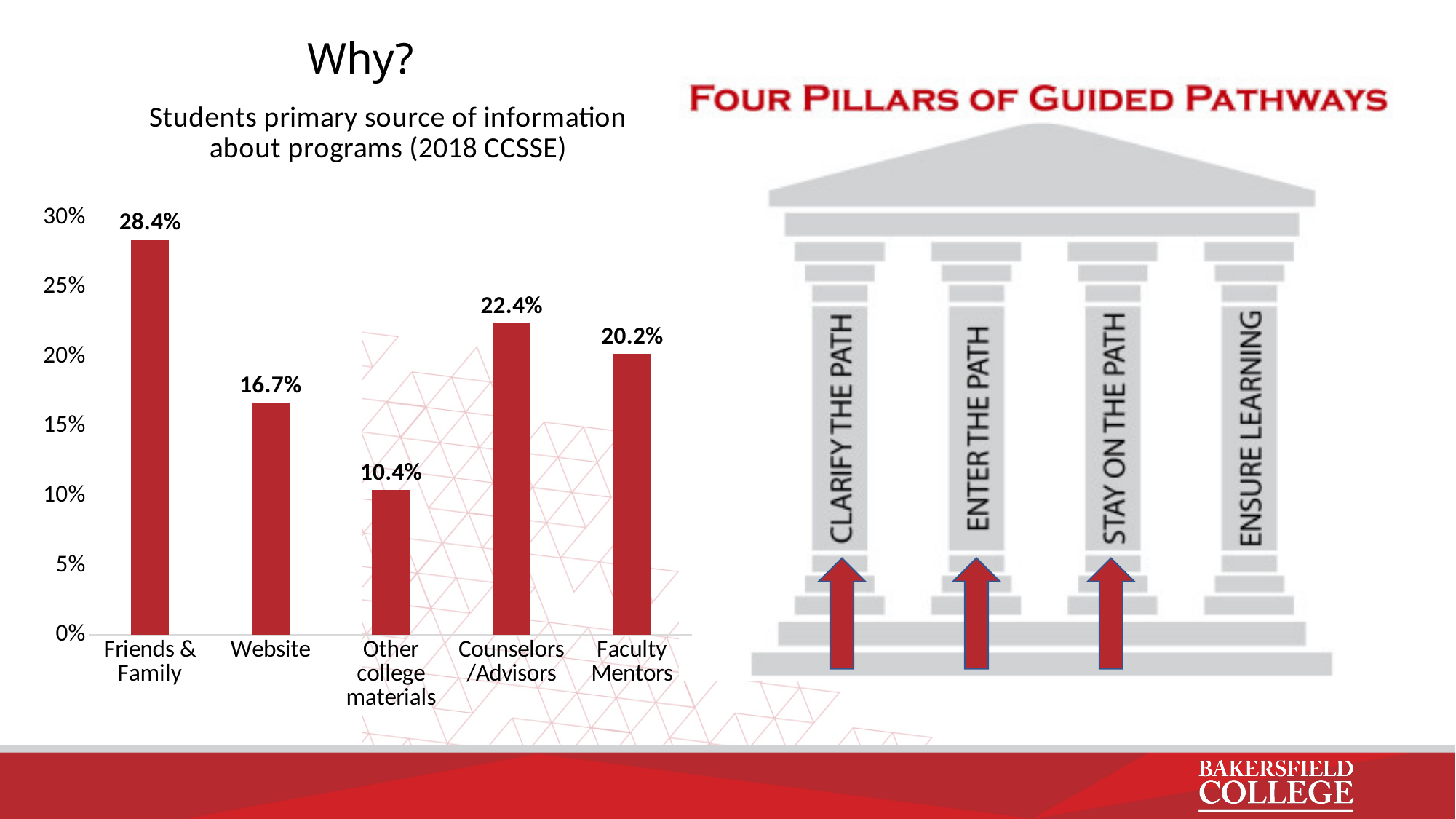
Which category has the highest value in the chart? Friends & Family What is the value for Counselors/Advisors? 22.4% Which category has the lowest value in the chart? Other college materials What is the value for Website in the chart? 16.7% Which is larger, the value for Counselors/Advisors or the value for Website? Counselors/Advisors What is the difference between the values for Friends & Family and Faculty Mentors? 8.2% What is the value for Other college materials? 10.4% What is the title of the chart? Students primary source of information about programs (2018 CCSSE) What kind of chart is shown on the slide? Bar chart Is the value for Faculty Mentors greater or less than 15%? greater What percentage of students cite Friends & Family as their primary source of information about programs? 28.4% How many categories are shown in the bar chart? 5